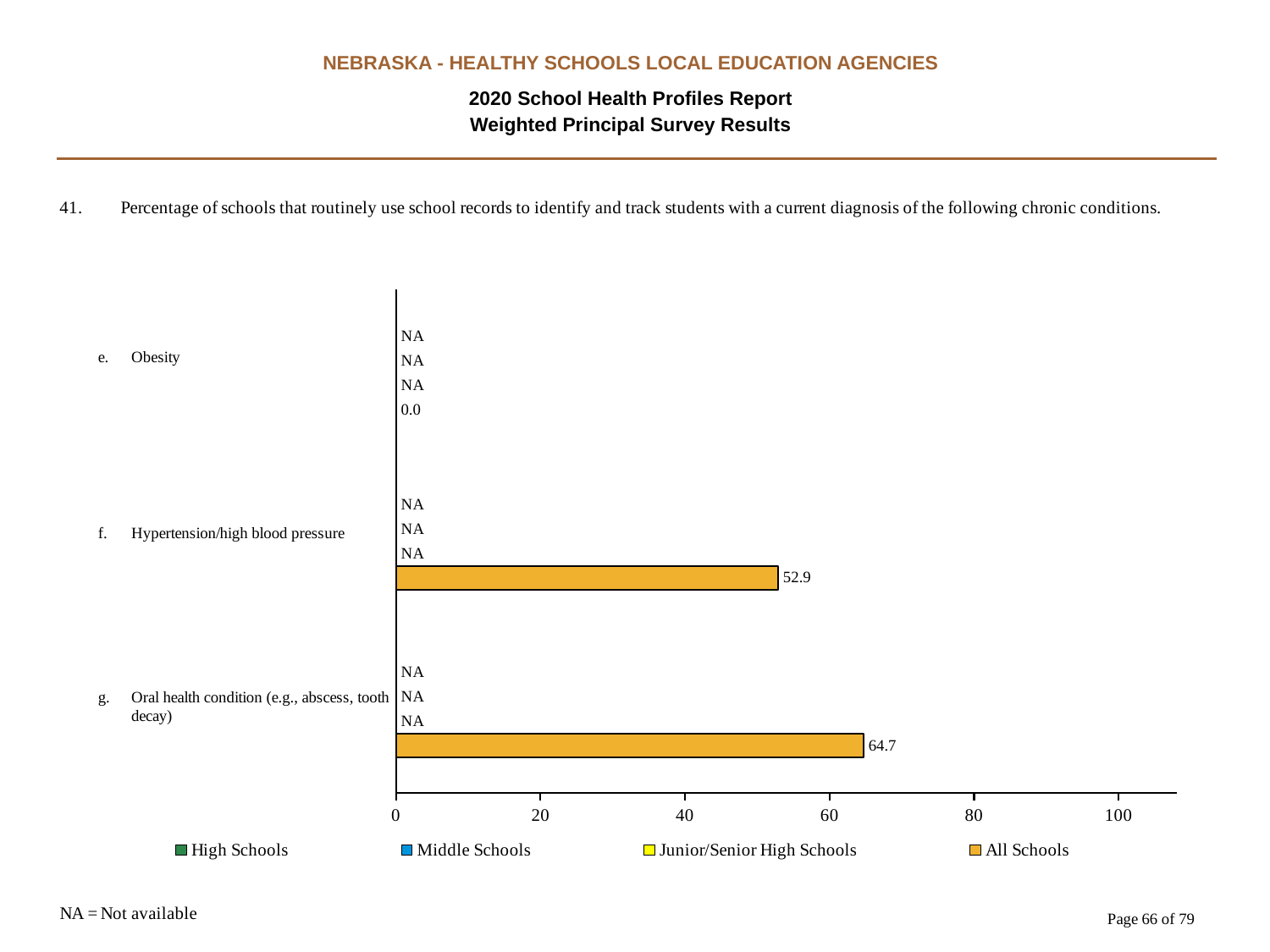
What is the All Schools value for Hypertension/high blood pressure? 52.9 Is the All Schools value for Hypertension/high blood pressure greater or less than 60? less How many chronic conditions are listed on the chart? 3 What kind of chart is shown on the slide? bar chart Which condition has the lowest All Schools value? Obesity What is the High Schools value for Obesity? NA Which has a larger All Schools value: Hypertension/high blood pressure or Oral health condition? Oral health condition What is the difference between the All Schools values for Oral health condition and Hypertension/high blood pressure? 11.8 Which condition has the highest All Schools value? Oral health condition (e.g., abscess, tooth decay) What is the All Schools value for Oral health condition (e.g., abscess, tooth decay)? 64.7 What is the All Schools value for Obesity? 0.0 How many series does the legend list? 4